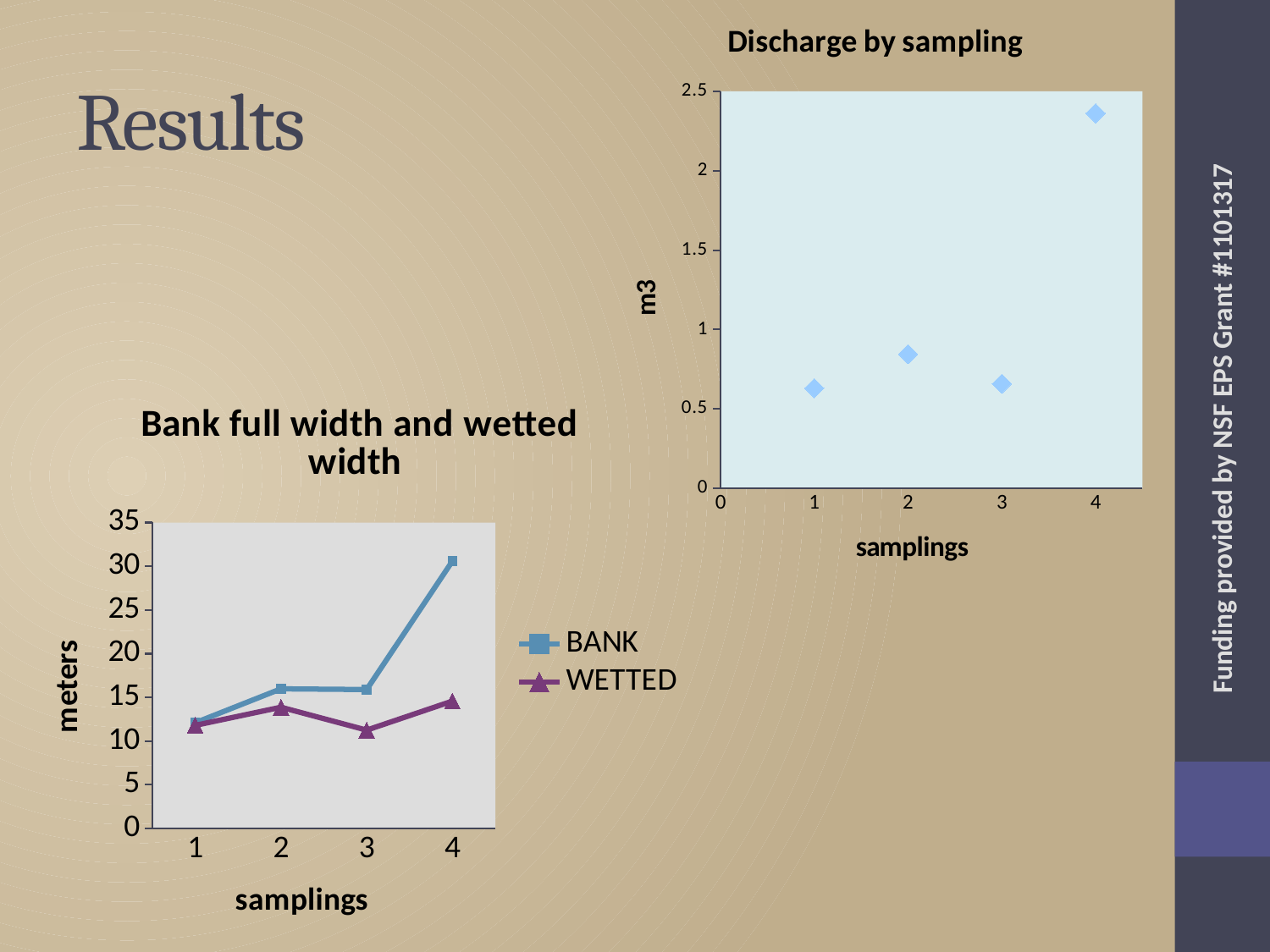
In the "Bank full width and wetted width" chart, how many series does the legend list? 2 What kind of chart is the "Discharge by sampling" chart? scatter chart In the "Bank full width and wetted width" chart, at which sampling is the BANK value highest? 4 In the "Bank full width and wetted width" chart, does the BANK series rise or fall from sampling 3 to sampling 4? rise How many samplings are plotted in the "Bank full width and wetted width" chart? 4 In the "Discharge by sampling" chart, is the value for sampling 1 greater or less than 1? less In the "Discharge by sampling" chart, is the value for sampling 4 greater or less than 2? greater In the "Bank full width and wetted width" chart, is the BANK value at sampling 4 greater or less than 25? greater In the "Discharge by sampling" chart, which sampling has the highest discharge? 4 What kind of chart is the "Bank full width and wetted width" chart? line chart In the "Bank full width and wetted width" chart, which series has the larger value at sampling 4, BANK or WETTED? BANK What is the y-axis label of the "Discharge by sampling" chart? m3